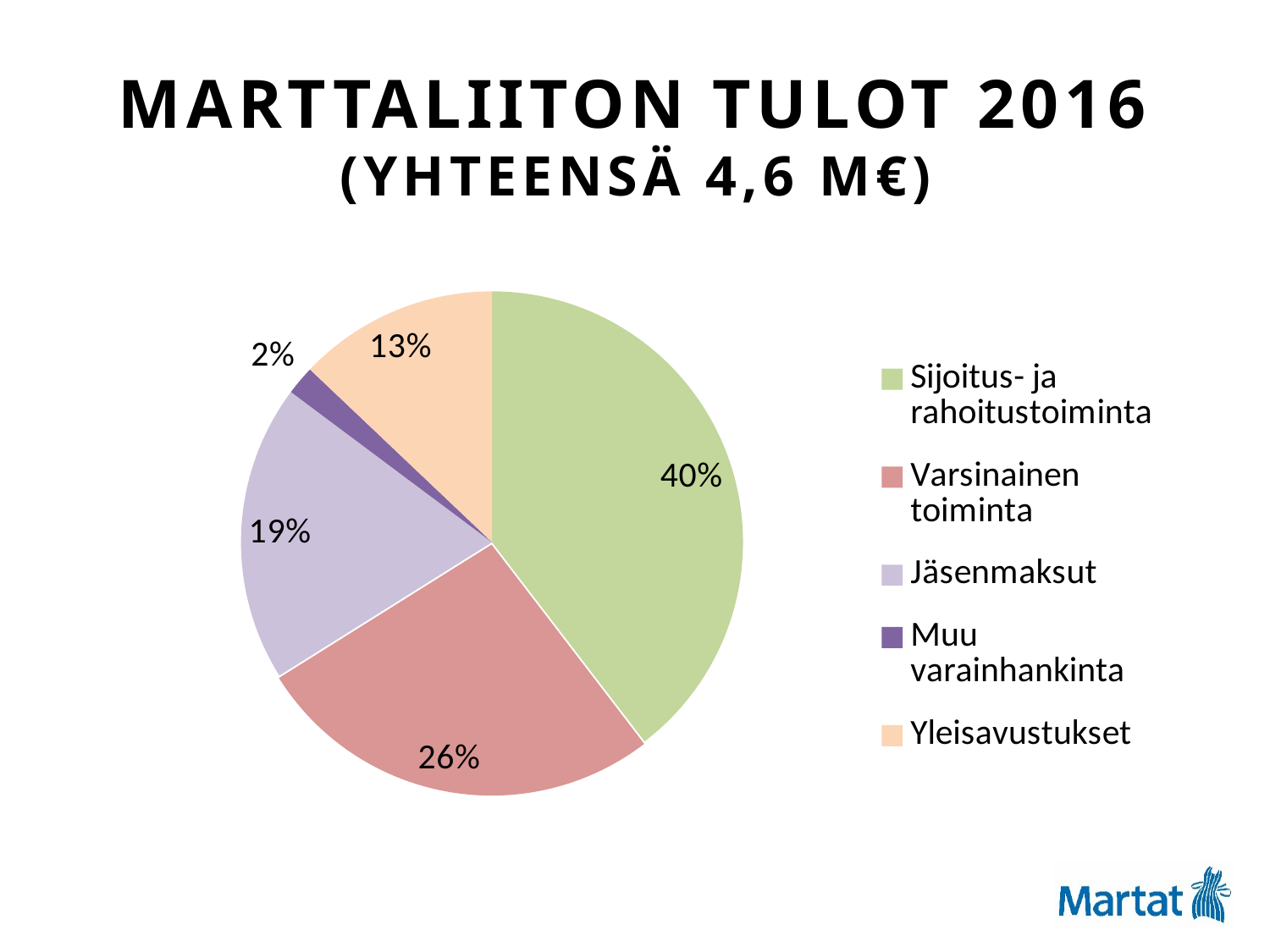
What share of the pie does Muu varainhankinta have? 2% How many categories does the pie chart have? 5 What share of the pie does Yleisavustukset have? 13% What share of the pie does Varsinainen toiminta have? 26% Which is larger, the share for Jäsenmaksut or the share for Yleisavustukset? Jäsenmaksut What kind of chart is shown on the slide? pie chart Which category has the largest slice of the pie? Sijoitus- ja rahoitustoiminta Which category has the smallest slice of the pie? Muu varainhankinta What is the title of the chart on the slide? MARTTALIITON TULOT 2016 (YHTEENSÄ 4,6 M€) What is the difference in percentage points between Sijoitus- ja rahoitustoiminta and Varsinainen toiminta? 14 percentage points